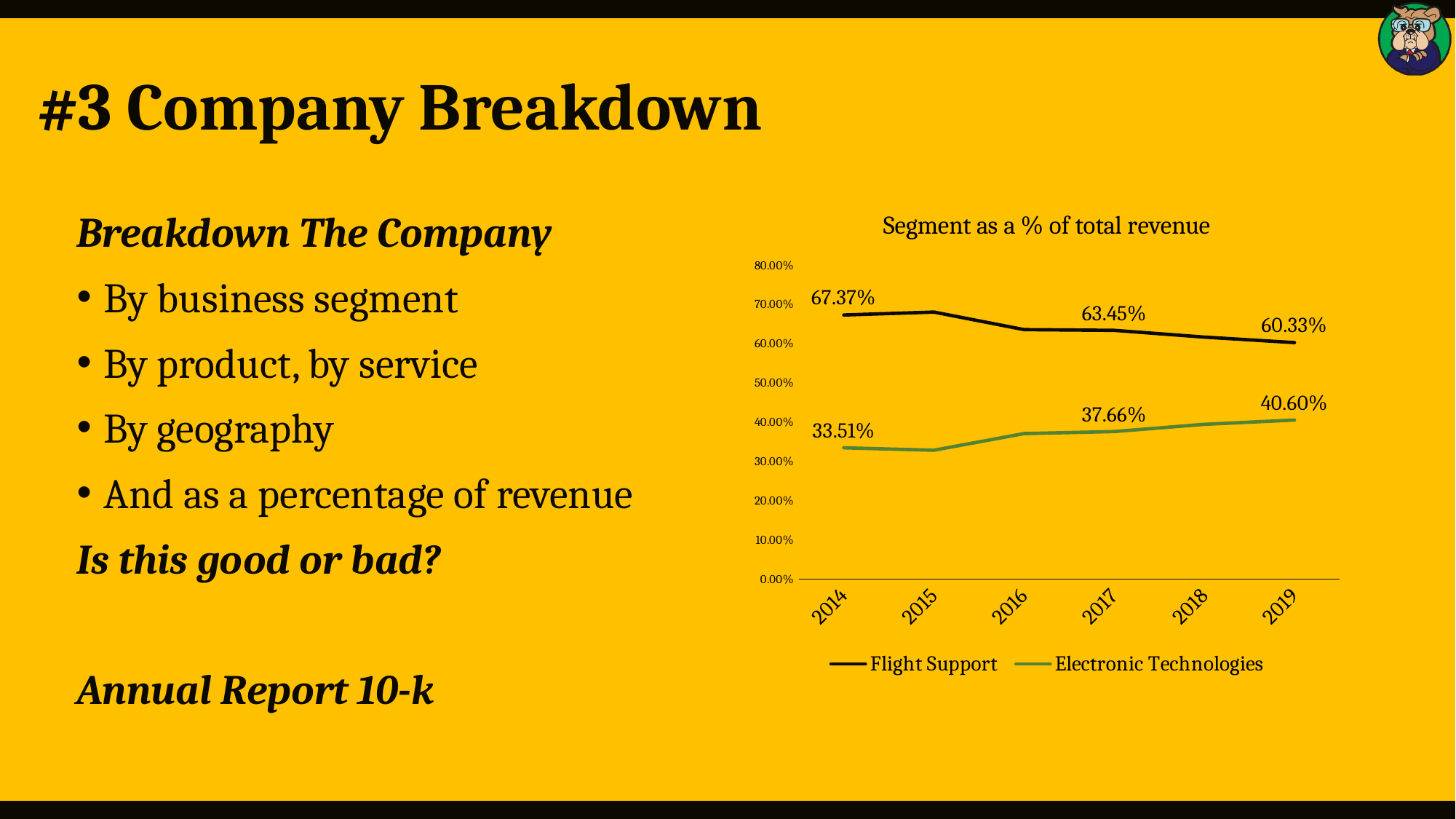
Is the value for Flight Support in 2015 greater or less than 60.00%? greater By how many percentage points did Flight Support's share fall from 2014 to 2019? 7.04 percentage points Which series has the larger value in 2019, Flight Support or Electronic Technologies? Flight Support By how many percentage points did Electronic Technologies' share rise from 2014 to 2019? 7.09 percentage points How many series does the chart's legend list? 2 What is the value for Flight Support in 2017? 63.45% What kind of chart is shown on the slide? Line chart Is the value for Electronic Technologies in 2016 greater or less than 40.00%? less What is the value for Electronic Technologies in 2014? 33.51% What is the value for Electronic Technologies in 2019? 40.60% How many years are shown on the x axis of the chart? 6 What is the value for Flight Support in 2014? 67.37%